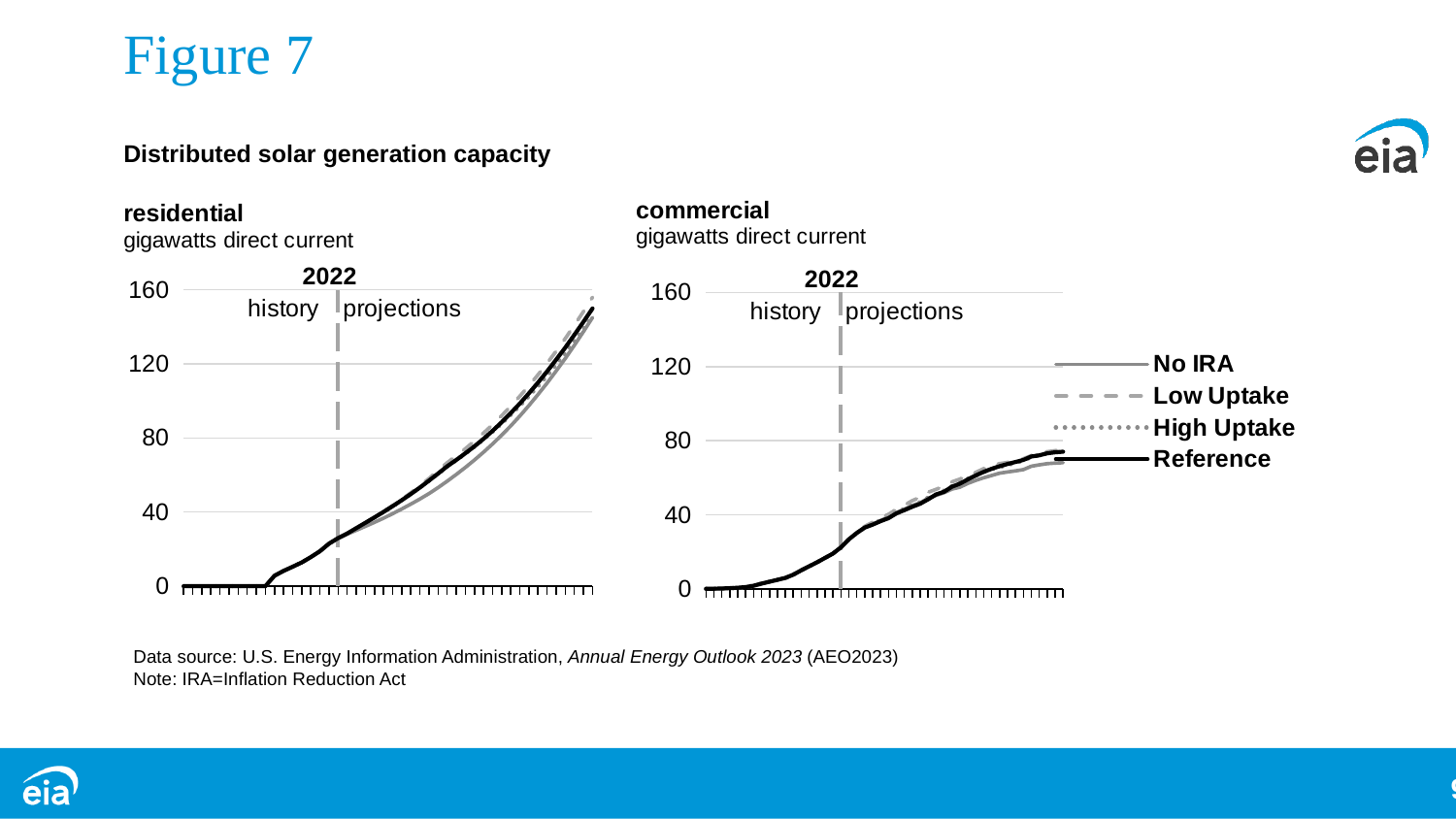
Which year separates history from projections in both charts? 2022 In the commercial chart, is the value in 2022 greater or less than 40? less What unit is shown on the y axis of both charts? gigawatts direct current What kind of chart is the residential chart? line chart In the commercial chart, do the values rise or fall along the x axis? rise At the end of the projection period, which chart shows the higher Reference capacity, residential or commercial? residential What kind of chart is the commercial chart? line chart In the residential chart, is the value in 2022 greater or less than 40? less In the residential chart, is the Reference value at the end of the projection period greater or less than 120? greater How many series does the legend list? 4 In the residential chart, do the projected values rise or fall after 2022? rise